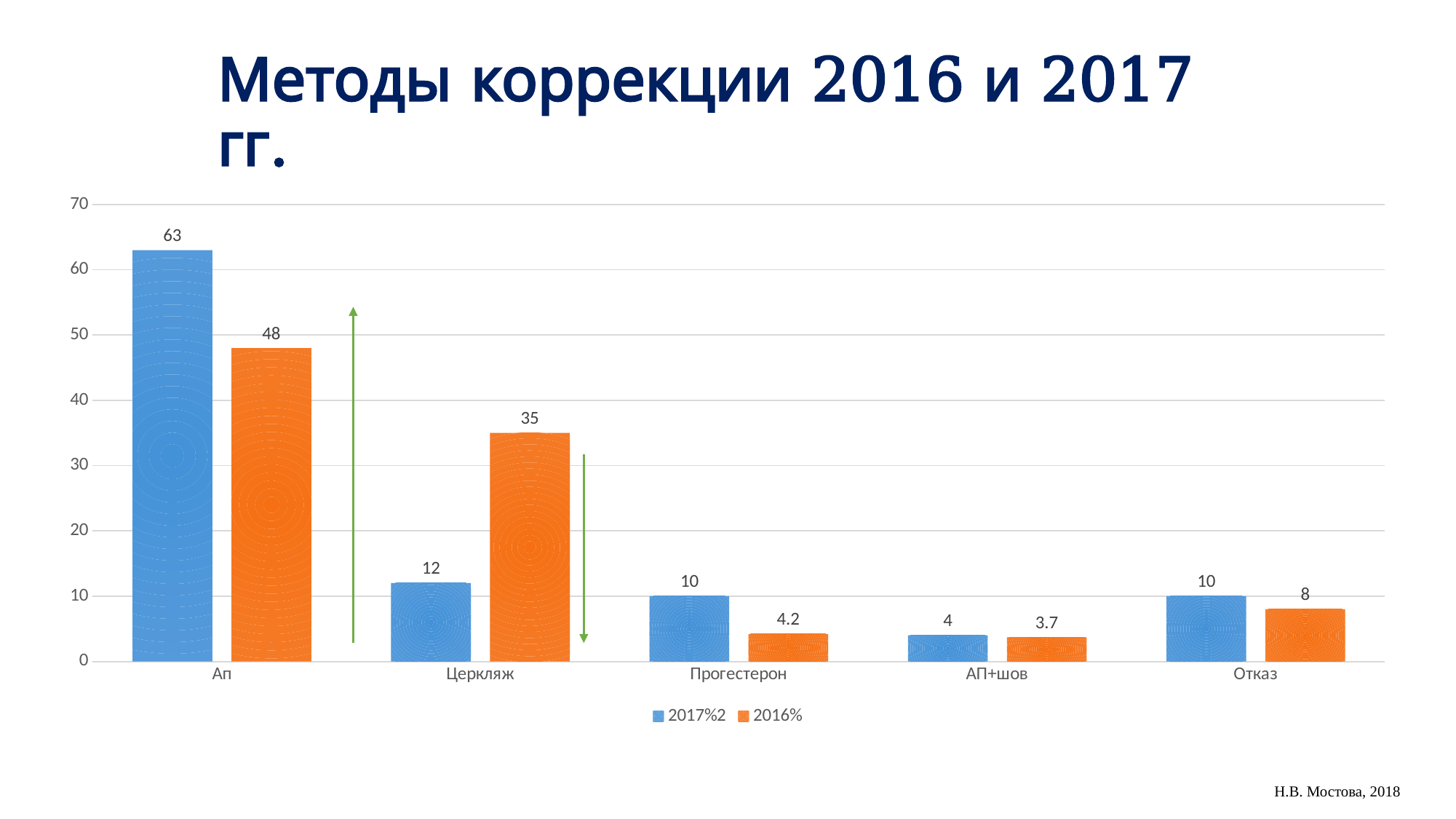
What is the value for Прогестерон in the 2016% series? 4.2 What is the value for Церкляж in the 2016% series? 35 What is the value for Ап in the 2017%2 series? 63 How many categories are shown on the x axis? 5 What is the value for АП+шов in the 2017%2 series? 4 How many series does the legend list? 2 What kind of chart is shown on the slide? Bar chart Which category has the lowest value in the 2017%2 series? АП+шов Which category has the highest value in the 2016% series? Ап Which is larger for Церкляж: the 2017%2 value or the 2016% value? 2016% What is the difference between the 2017%2 and 2016% values for Ап? 15 What is the difference between the 2017%2 and 2016% values for Отказ? 2